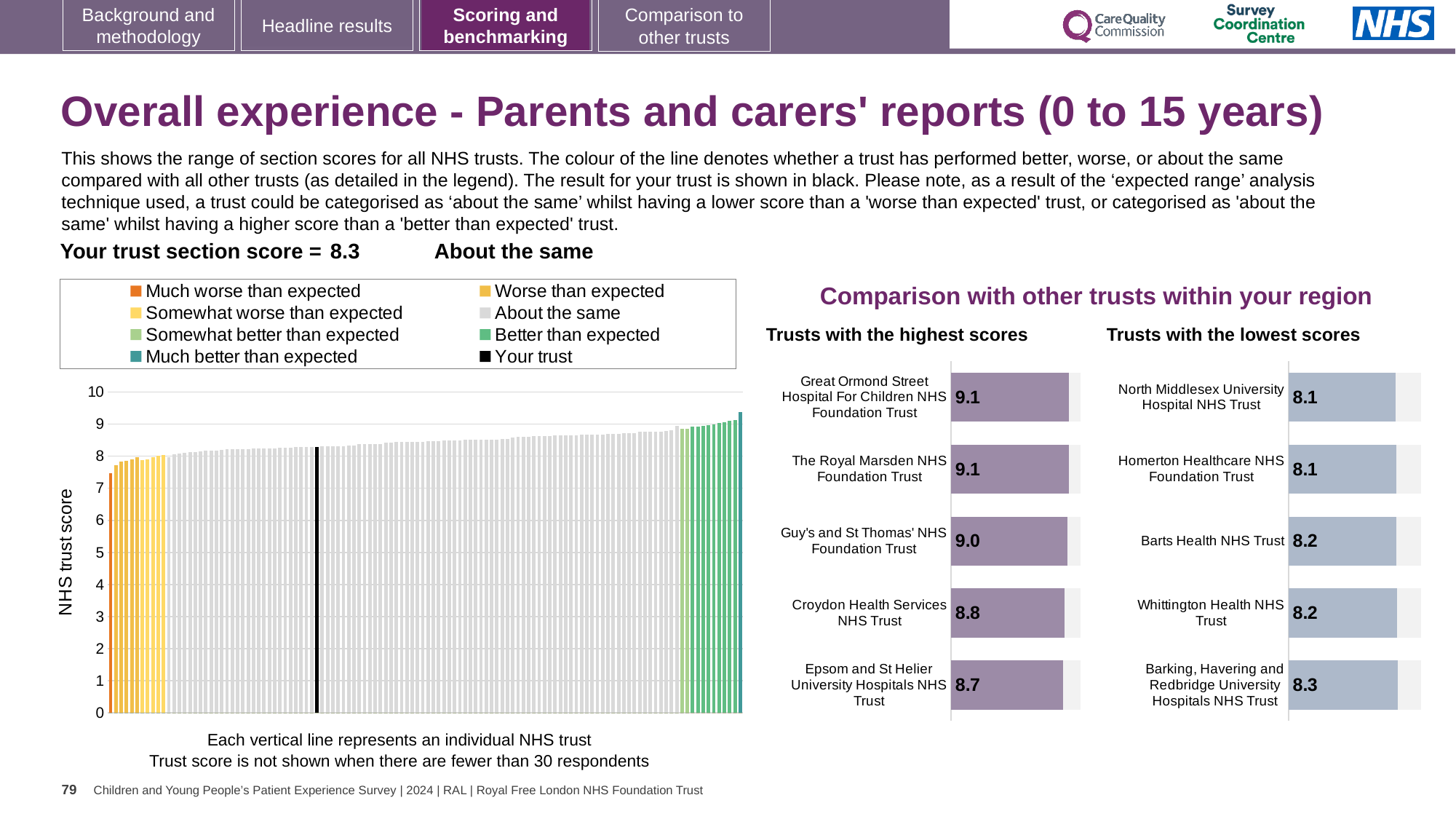
How many entries does the legend above the large 'NHS trust score' chart list? 8 In the 'Trusts with the highest scores' chart, which trust has the lowest score? Epsom and St Helier University Hospitals NHS Trust In the 'Trusts with the lowest scores' chart, which has the larger score: Barts Health NHS Trust or Barking, Havering and Redbridge University Hospitals NHS Trust? Barking, Havering and Redbridge University Hospitals NHS Trust In the 'Trusts with the highest scores' chart, what is the score for Croydon Health Services NHS Trust? 8.8 In the 'Trusts with the lowest scores' chart, what is the score for Barts Health NHS Trust? 8.2 In the 'Trusts with the lowest scores' chart, which trust has the highest score? Barking, Havering and Redbridge University Hospitals NHS Trust In the large 'NHS trust score' chart on the left, do the bar values rise or fall from left to right? rise What kind of chart is the large 'NHS trust score' chart on the left? bar chart In the 'Trusts with the highest scores' chart, what is the difference between the scores of Great Ormond Street Hospital For Children NHS Foundation Trust and Epsom and St Helier University Hospitals NHS Trust? 0.4 In the 'Trusts with the highest scores' chart, what is the score for Great Ormond Street Hospital For Children NHS Foundation Trust? 9.1 How many trusts are shown in the 'Trusts with the highest scores' chart? 5 In the large 'NHS trust score' chart on the left, is the value for the black 'Your trust' bar greater or less than 8? greater